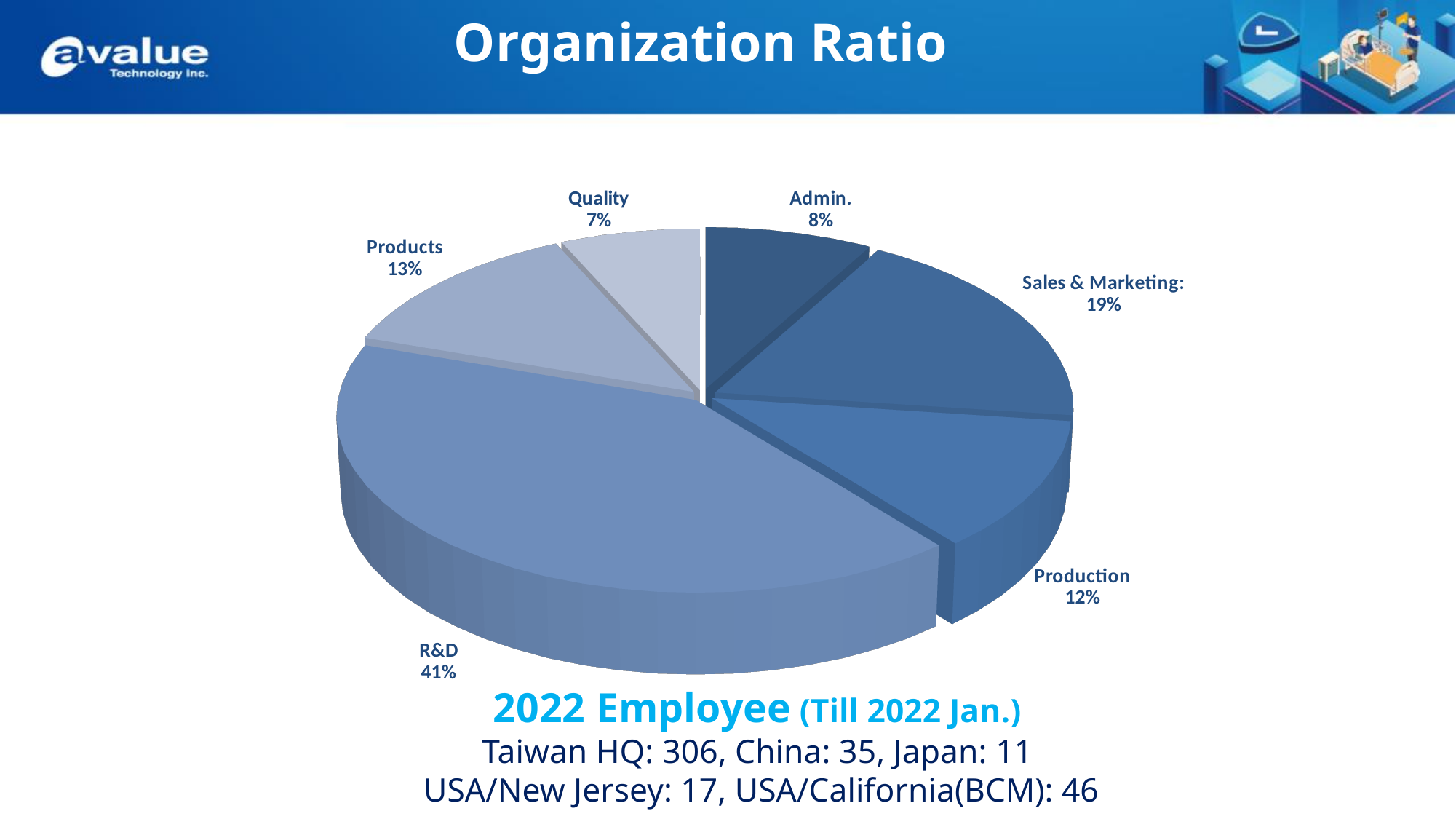
Which category has the smallest slice of the pie? Quality What kind of chart is shown on the slide? Pie chart What percentage is shown for Quality? 7% What is the difference in percentage points between R&D and Sales & Marketing? 22 Which is larger, Admin. or Quality? Admin. How many categories are shown in the pie chart? 6 What percentage is shown for Sales & Marketing? 19% What is the value for Production? 12% What is the difference in percentage points between Products and Production? 1 What is the title of the slide containing the chart? Organization Ratio Which category has the largest slice of the pie? R&D What share of the pie does R&D represent? 41%